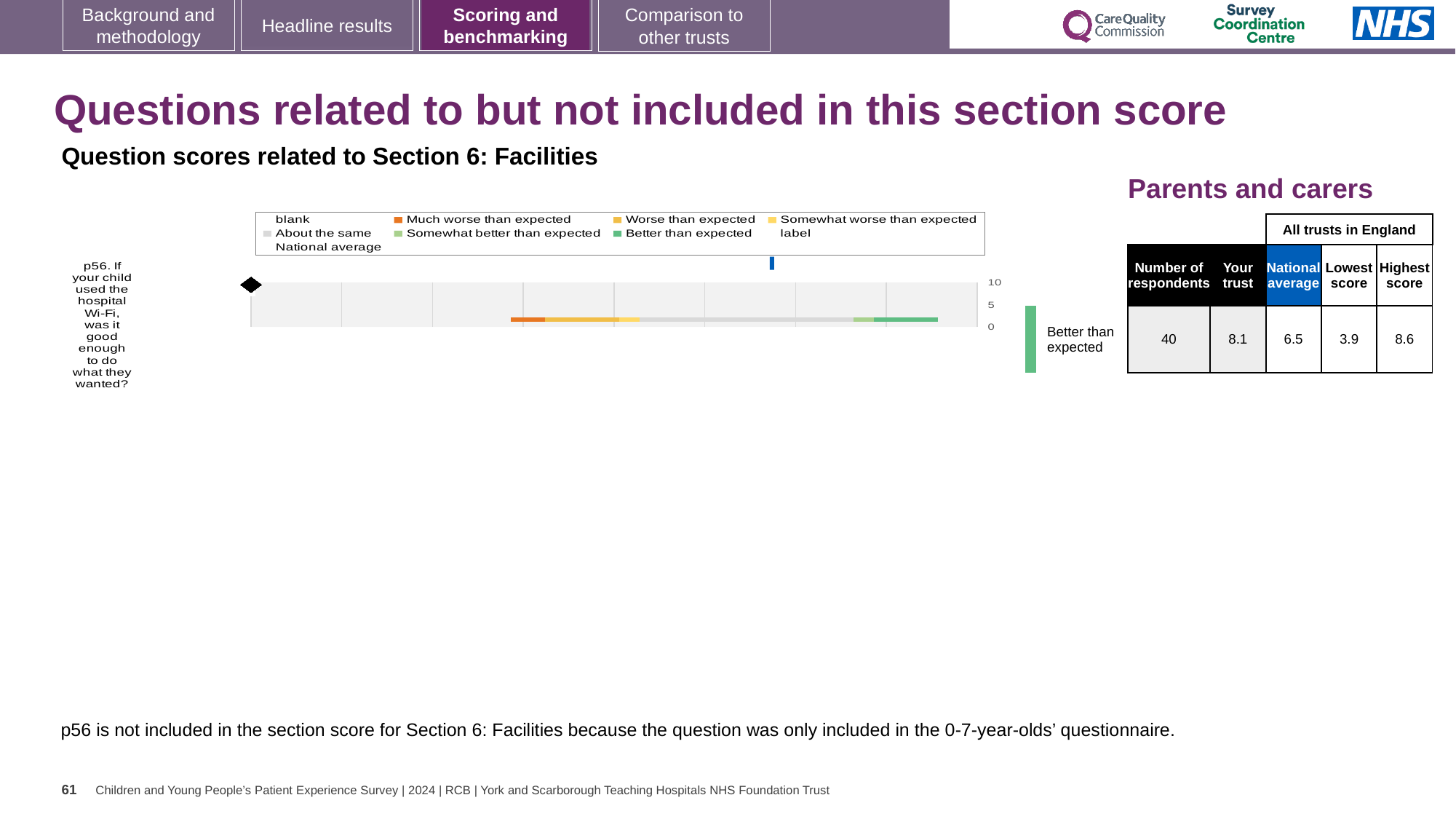
Which benchmark category does the green marker beside the chart indicate for p56? Better than expected In the table next to the chart, how many respondents answered p56? 40 In the table next to the chart, what is the Highest score among all trusts in England for p56? 8.6 In the table next to the chart, what is the Lowest score among all trusts in England for p56? 3.9 Which question is plotted in the chart? p56. If your child used the hospital Wi-Fi, was it good enough to do what they wanted? How many survey questions are plotted in the chart? 1 In the table next to the chart, what is the National average for p56? 6.5 What kind of chart is shown for question p56? bar chart For p56, what is the difference between the 'Your trust' score and the National average? 1.6 In the table next to the chart, what is the 'Your trust' score for p56? 8.1 For p56, which is larger: the 'Your trust' score or the National average? Your trust